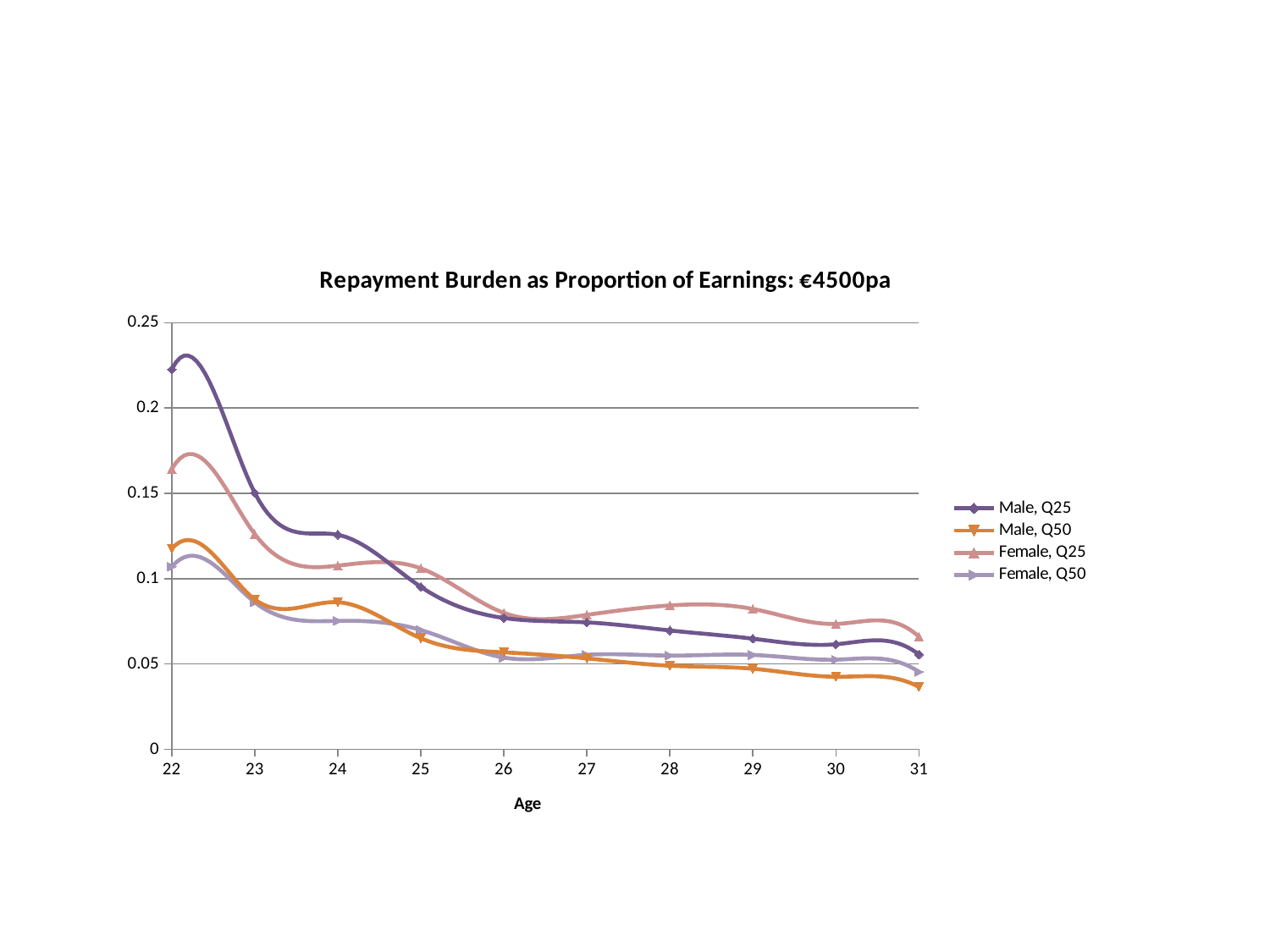
Which series has the lowest value at age 31? Male, Q50 Is the value for Female, Q25 at age 22 greater or less than 0.15? greater What is the label on the x axis? Age Is the value for Male, Q50 at age 31 greater or less than 0.05? less How many ages are plotted along the x axis? 10 What is the title of the chart? Repayment Burden as Proportion of Earnings: €4500pa Which series has the highest value at age 22? Male, Q25 Is the value for Male, Q25 at age 24 greater or less than 0.1? greater What kind of chart is shown on the slide? line chart At age 28, which is larger: Female, Q25 or Male, Q25? Female, Q25 How many series does the legend list? 4